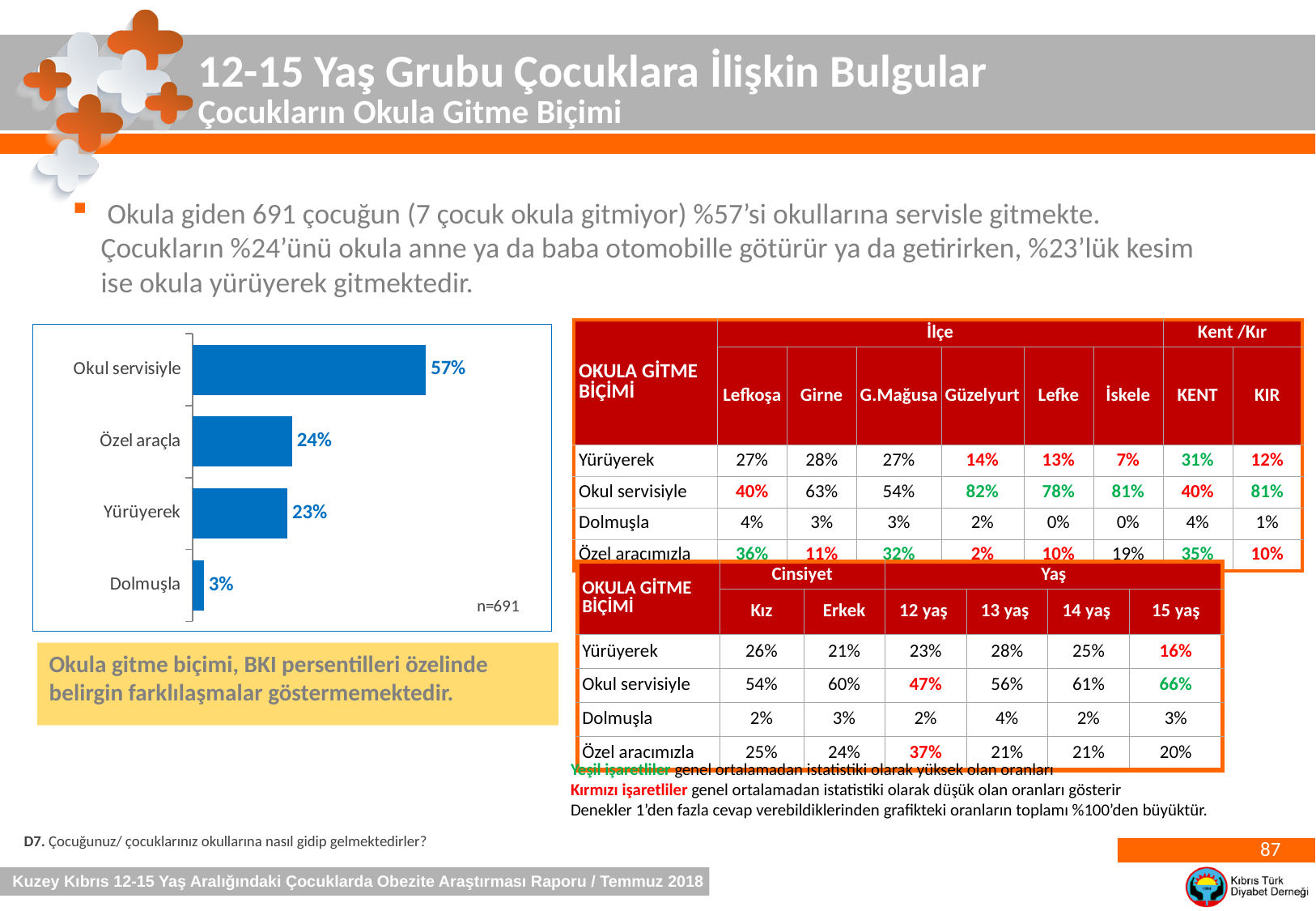
What is the difference between the values for Okul servisiyle and Özel araçla in the bar chart? 33% What is the value for Özel araçla in the bar chart? 24% In the bar chart, which is larger: the value for Okul servisiyle or the value for Yürüyerek? Okul servisiyle What is the difference between the values for Yürüyerek and Dolmuşla in the bar chart? 20% What is the value for Okul servisiyle in the bar chart? 57% What kind of chart is shown on the left of the slide? Bar chart What sample size (n) is noted on the bar chart? n=691 Which category has the highest value in the bar chart? Okul servisiyle What is the value for Yürüyerek in the bar chart? 23% What is the value for Dolmuşla in the bar chart? 3% Which category has the lowest value in the bar chart? Dolmuşla How many categories are shown in the bar chart? 4